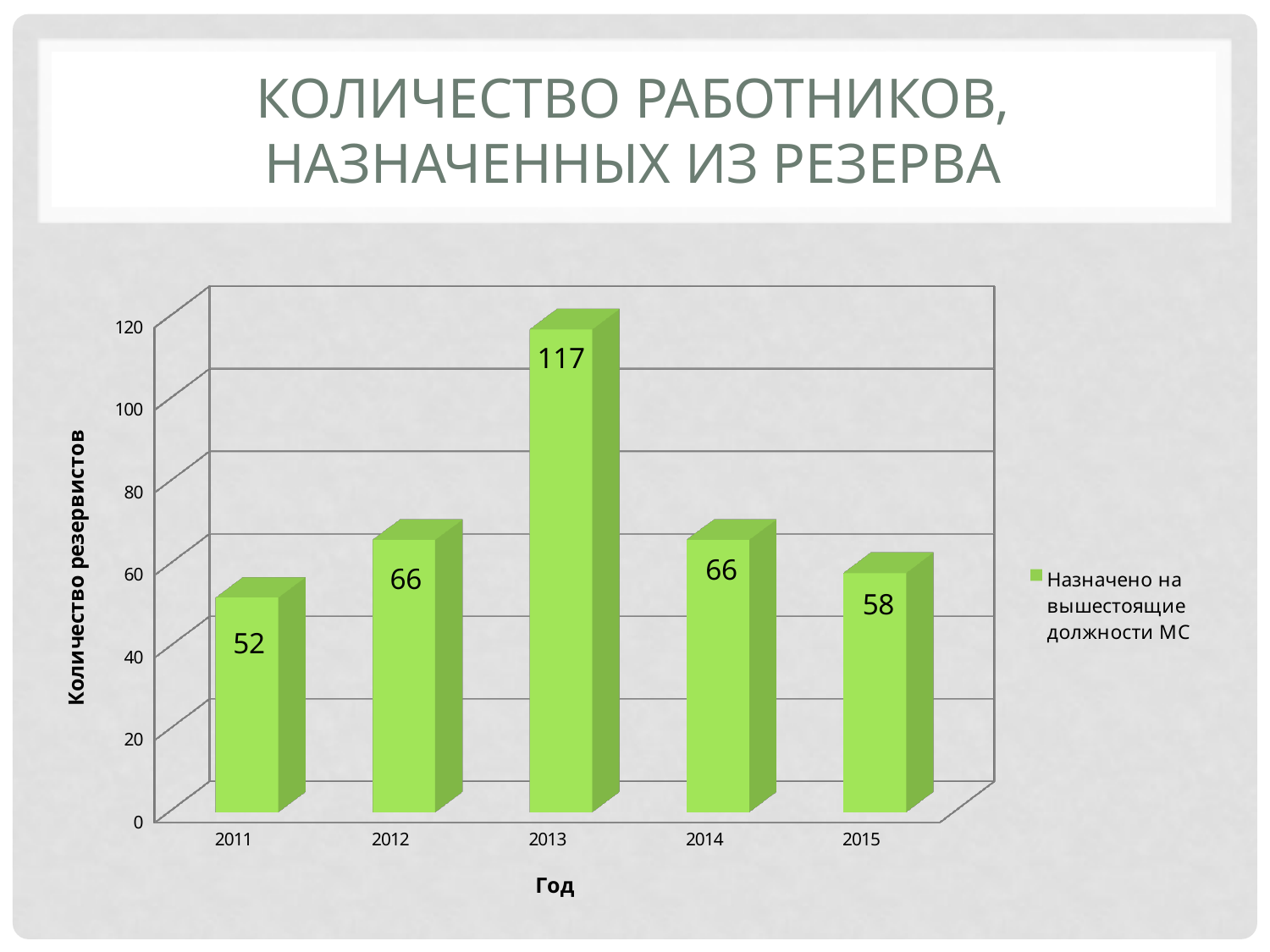
Which is larger, the value for 2014 or the value for 2015? 2014 What is the label of the x axis? Год What is the difference between the values for 2013 and 2012? 51 Is the value for 2013 greater or less than 100? greater What is the value for 2013? 117 What is the value for 2015? 58 Which year has the highest value? 2013 What is the value for 2011? 52 What kind of chart is shown on the slide? bar chart How many years are shown on the x axis? 5 Which year has the lowest value? 2011 What is the difference between the values for 2015 and 2011? 6